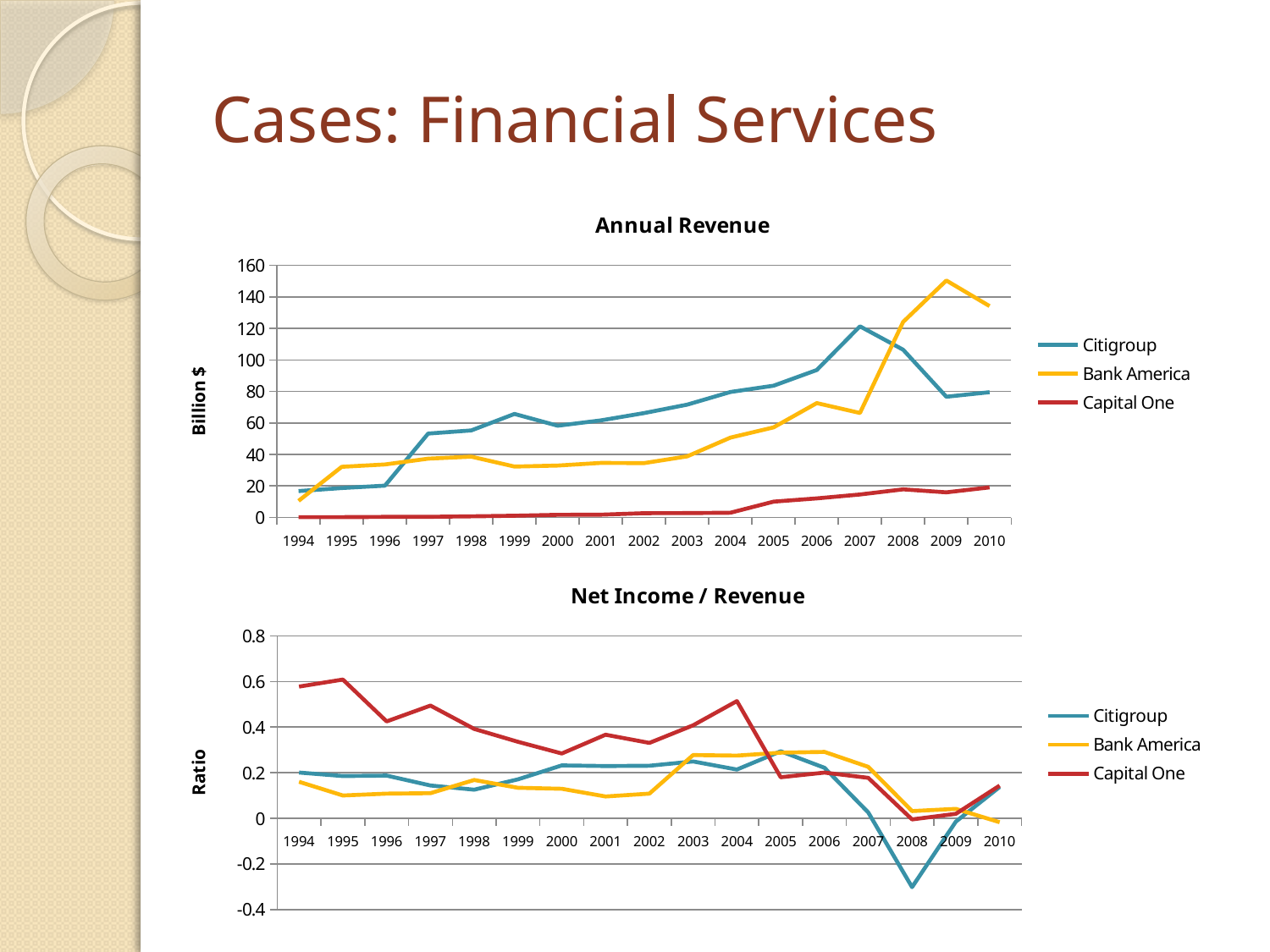
What is the y-axis label of the Annual Revenue chart? Billion $ In the Annual Revenue chart, which company has the highest revenue in 2009? Bank America How many years are plotted on the x axis of the Net Income / Revenue chart? 17 How many series does the legend of the Annual Revenue chart list? 3 What type of chart is the Annual Revenue chart? line chart In the Annual Revenue chart, is the value for Bank America in 2009 greater or less than 140? greater In the Annual Revenue chart, is the value for Citigroup in 2007 greater or less than 100? greater In the Net Income / Revenue chart, is the value for Citigroup in 2008 greater or less than 0? less In the Annual Revenue chart, which company has the lowest revenue in 2005? Capital One In the Net Income / Revenue chart, in which year does Citigroup reach its lowest ratio? 2008 In the Annual Revenue chart, which is larger in 2007, Citigroup or Bank America? Citigroup In the Net Income / Revenue chart, which company has the highest ratio in 1995? Capital One